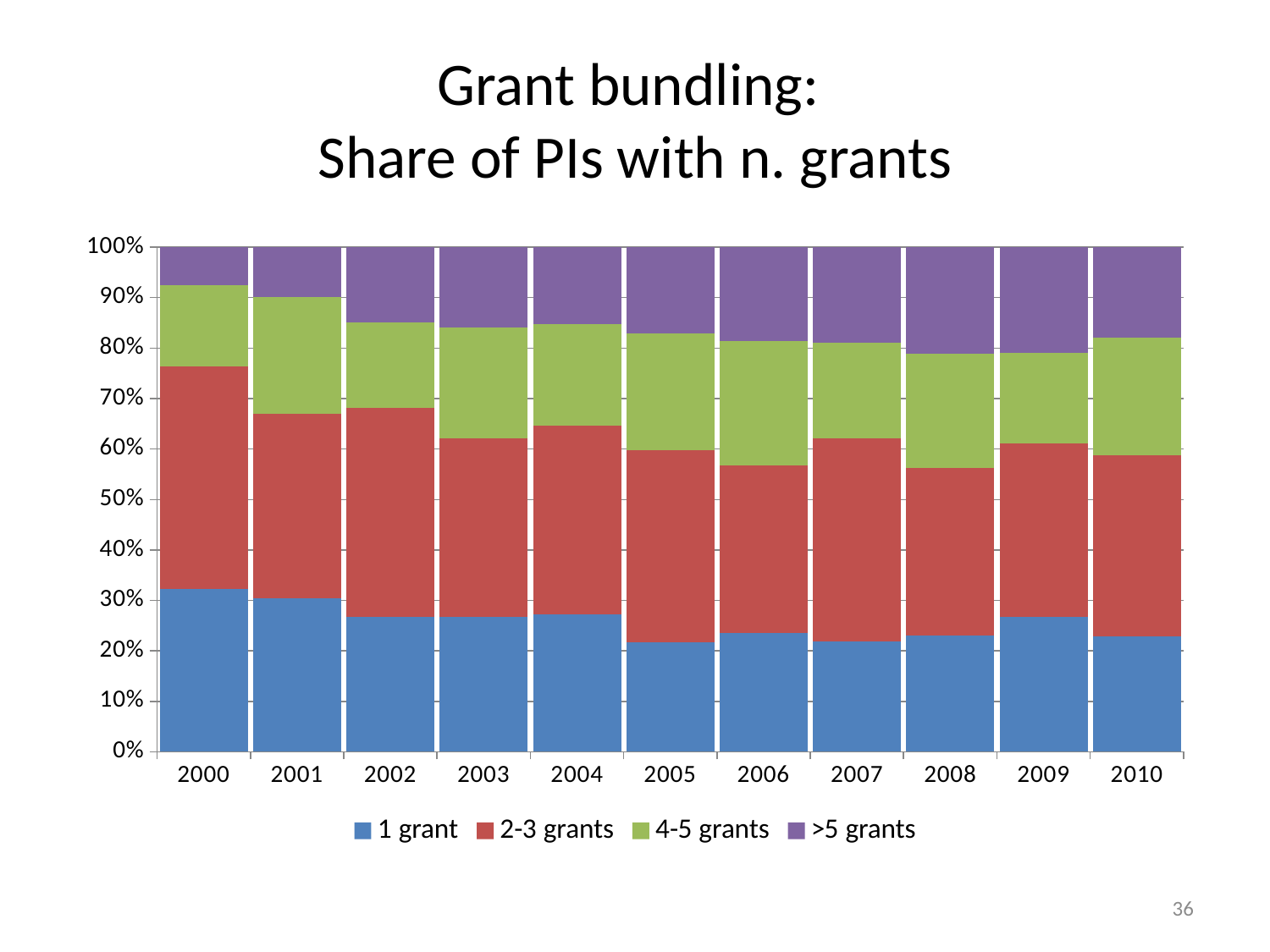
In which year is the share of PIs with >5 grants the smallest? 2000 How many years are shown along the x axis? 11 What is the title of the chart? Grant bundling: Share of PIs with n. grants How many series does the legend list? 4 Is the share of PIs with >5 grants larger in 2000 or in 2010? 2010 Is the share of PIs with 1 grant larger in 2000 or in 2010? 2000 Is the share of PIs with 1 grant in 2000 greater or less than 30%? greater Which series is shown in blue in the legend? 1 grant Does the share of PIs with 1 grant generally rise or fall from 2000 to 2010? fall Is the share of PIs with 1 grant in 2005 greater or less than 30%? less What kind of chart is shown on the slide? stacked bar chart In which year is the share of PIs with 1 grant the highest? 2000